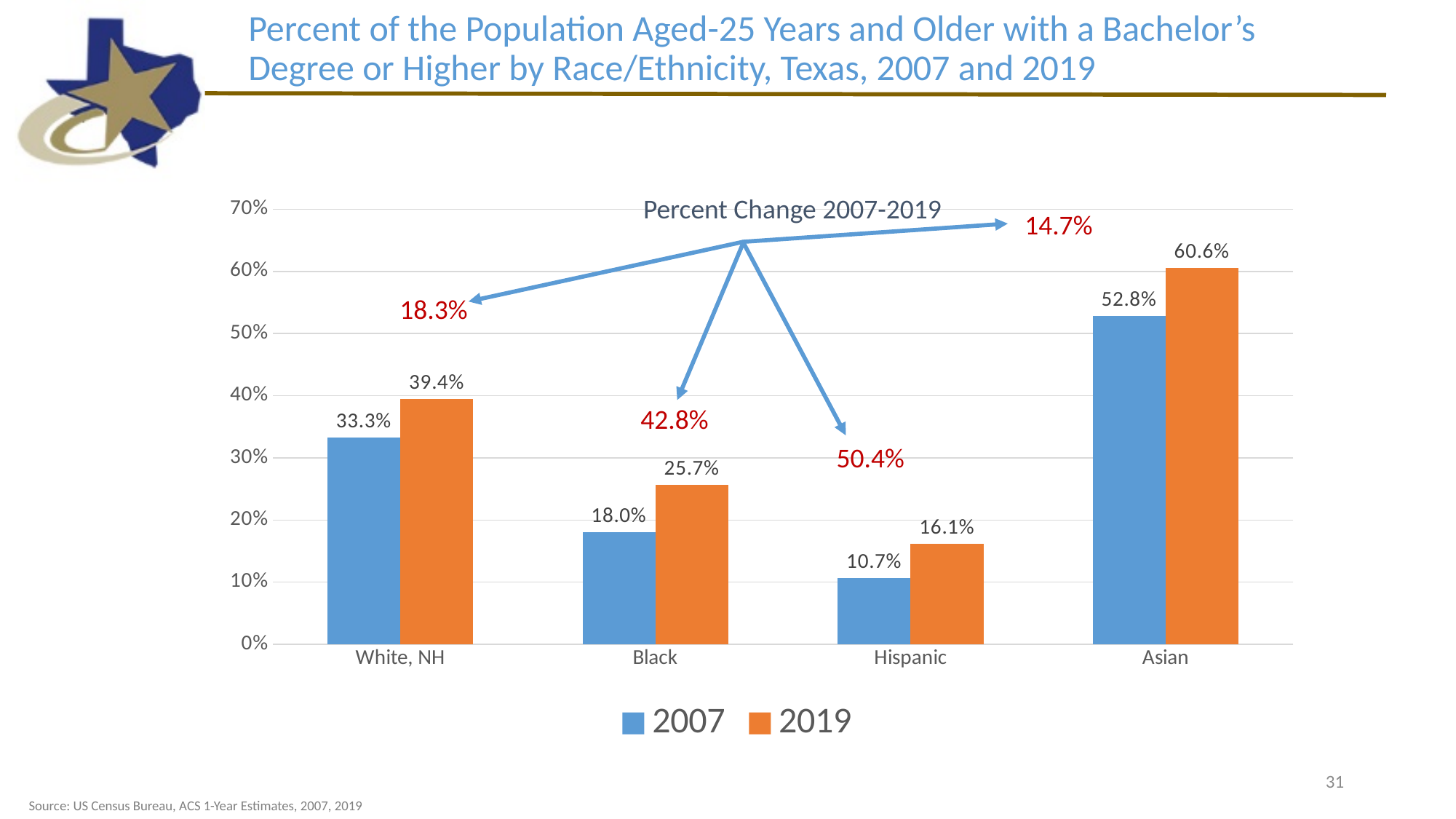
What was the percent of the population aged 25 and older with a bachelor's degree or higher for Hispanic in 2019? 16.1% What is the difference between the 2019 and 2007 values for White, NH? 6.1% Which race/ethnicity group had the lowest value in 2007? Hispanic What was the value for Asian in 2007? 52.8% Which is larger: the 2019 value for Black or the 2007 value for White, NH? 2007 value for White, NH How many series does the legend list? 2 How many race/ethnicity categories are shown on the x axis? 4 Which race/ethnicity group had the highest value in 2019? Asian Is the 2019 value for Asian greater or less than 60%? greater What kind of chart is shown on the slide? Bar chart What percent change from 2007 to 2019 is annotated for the Hispanic group? 50.4% What was the value for Black in 2007? 18.0%